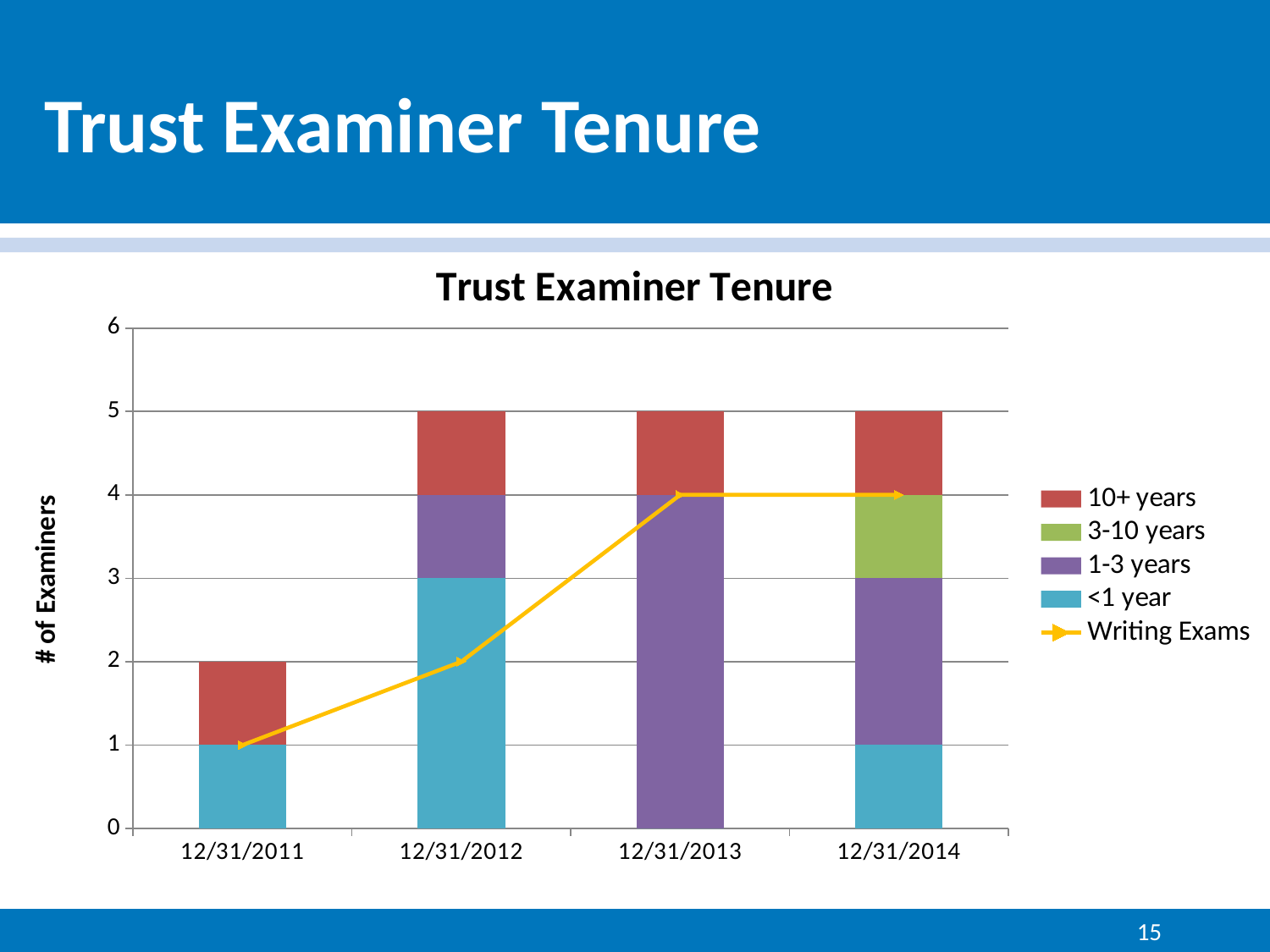
What is the value of Writing Exams at 12/31/2013? 4 How many series does the legend list? 5 What kind of chart is shown on the slide? Stacked bar chart with a line How many dates are shown on the x axis? 4 What is the total number of examiners for 12/31/2011? 2 What is the value of Writing Exams at 12/31/2011? 1 What is the label of the y axis? # of Examiners What is the total number of examiners for 12/31/2012? 5 What is the value for 1-3 years at 12/31/2013? 4 Does the Writing Exams line rise or fall from 12/31/2011 to 12/31/2013? Rise Which date has the lowest total number of examiners? 12/31/2011 What is the value for <1 year at 12/31/2012? 3